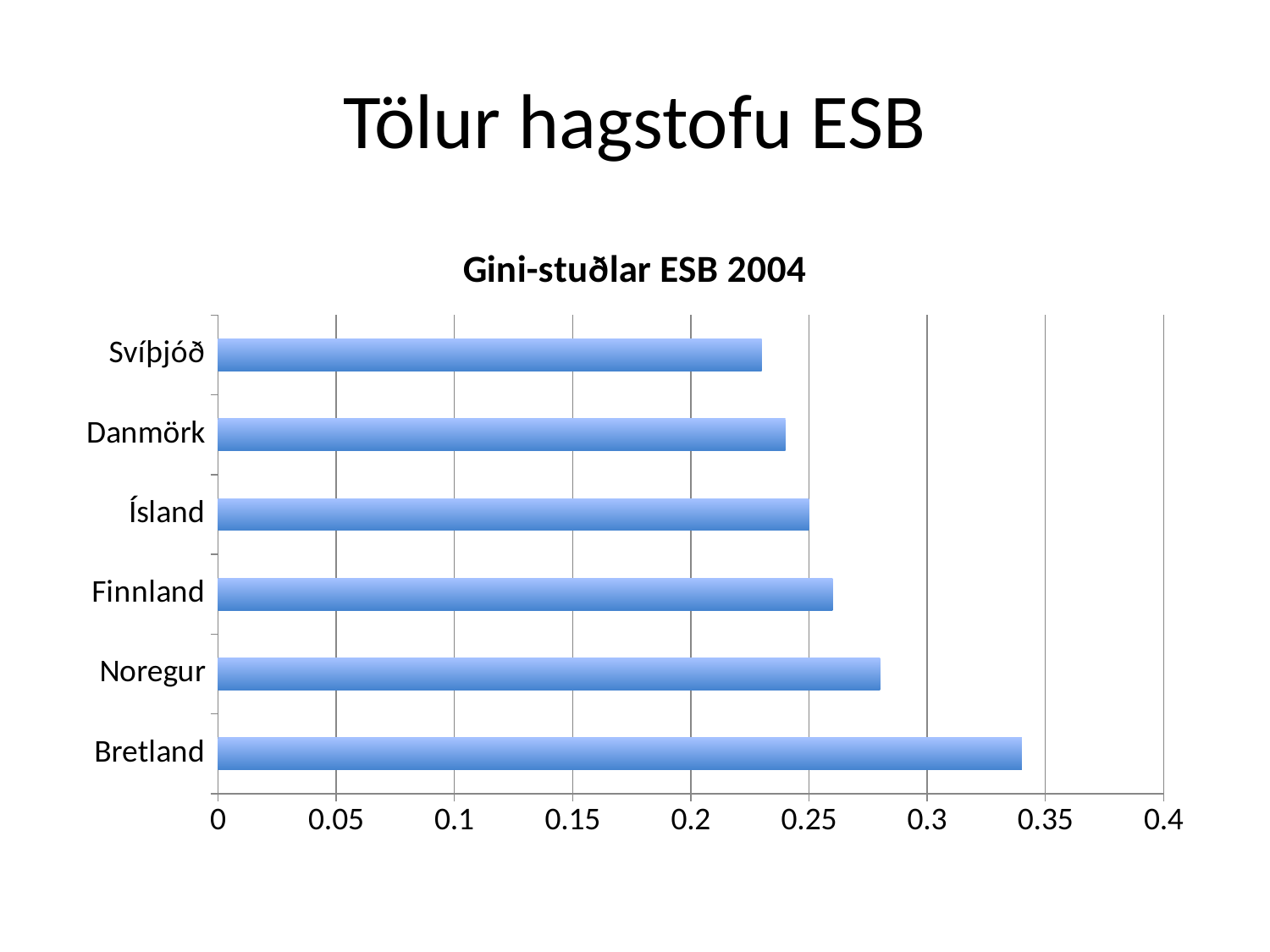
Is the value for Svíþjóð greater or less than 0.25? less Is the value for Bretland greater or less than 0.3? greater Is the value for Noregur greater or less than 0.25? greater What type of chart is shown on the slide? bar chart Which has a larger value, Noregur or Ísland? Noregur What is the title of the chart? Gini-stuðlar ESB 2004 How many countries are shown in the chart? 6 What is the value for Ísland? 0.25 Which country has the lowest value in the chart? Svíþjóð Which country has the highest value in the chart? Bretland Which has a larger value, Bretland or Finnland? Bretland